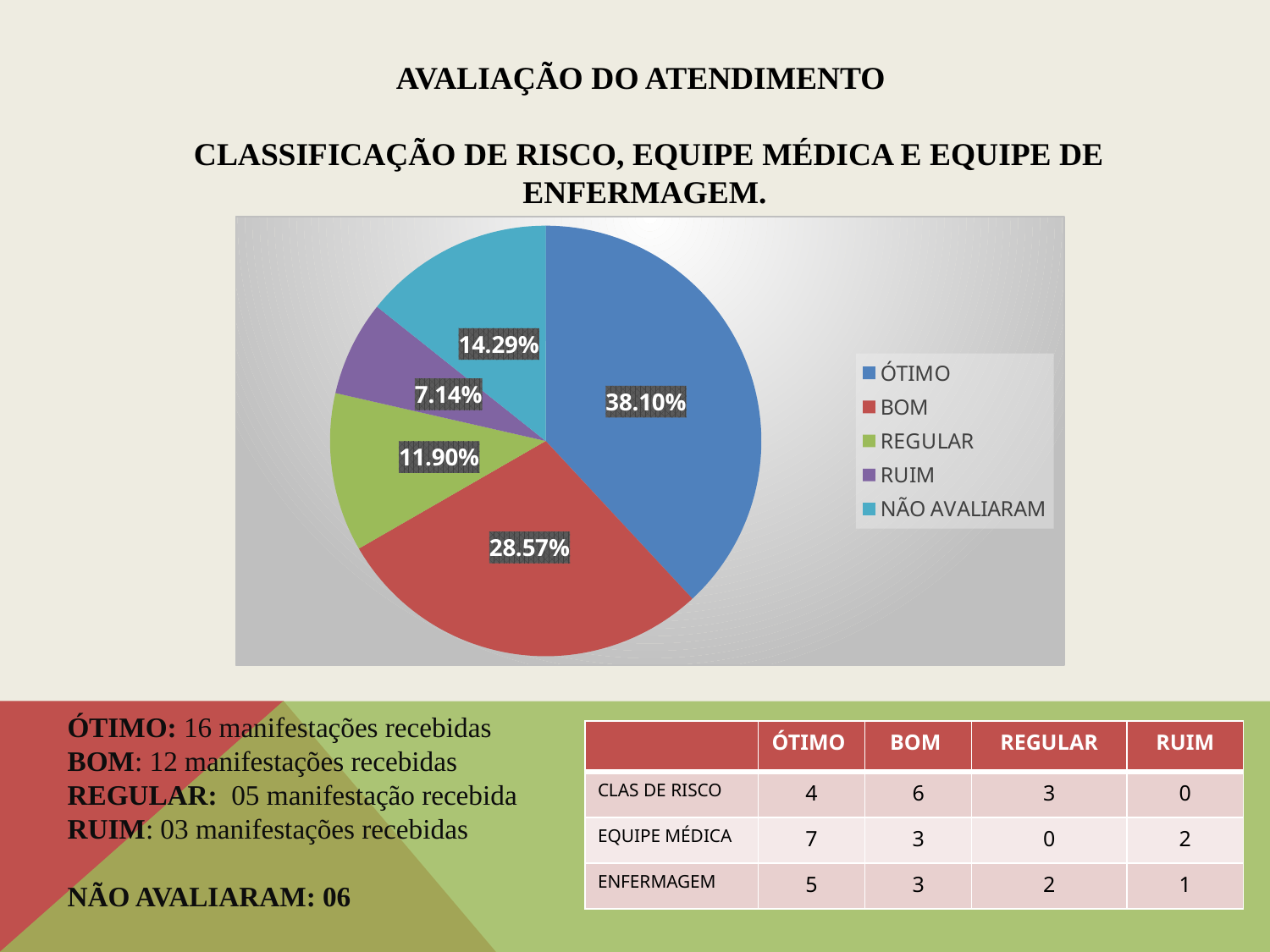
Which category has the smallest share of the pie? RUIM What percentage does the REGULAR slice show? 11.90% Which category has the largest share of the pie? ÓTIMO How many slices does the pie chart have? 5 What kind of chart is shown on the slide? pie chart Which slice is larger, NÃO AVALIARAM or REGULAR? NÃO AVALIARAM What is the difference in percentage points between the ÓTIMO and BOM slices? 9.53% What percentage does the BOM slice show? 28.57% What percentage does the NÃO AVALIARAM slice show? 14.29% What colour is the ÓTIMO slice in the pie chart? blue What percentage does the RUIM slice show? 7.14% What percentage does the ÓTIMO slice show? 38.10%